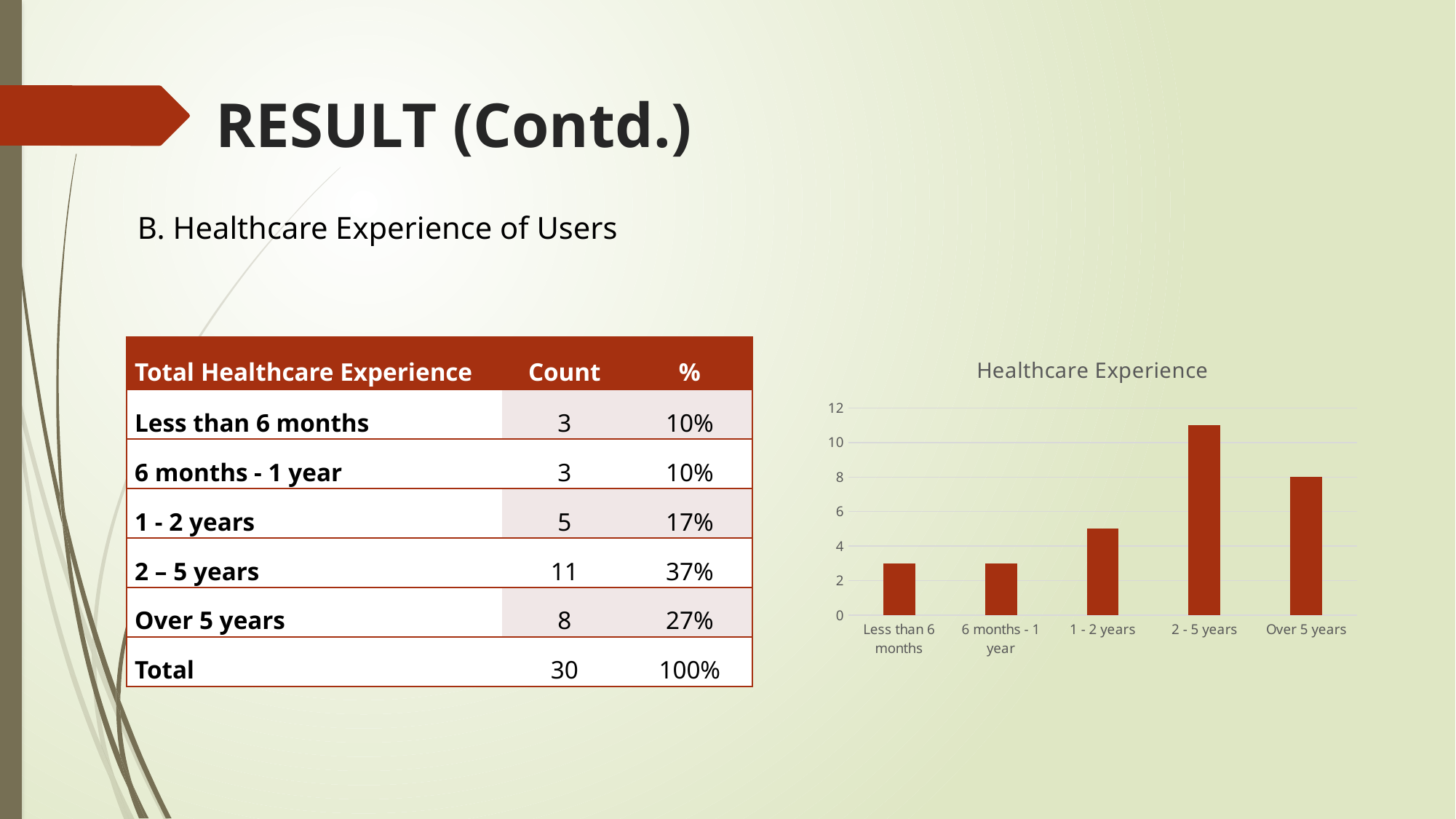
What is the highest value shown on the y axis of the Healthcare Experience chart? 12 Is the value for 2 - 5 years greater or less than 10 in the Healthcare Experience chart? greater Which is larger in the Healthcare Experience chart, 1 - 2 years or Over 5 years? Over 5 years What is the value for Over 5 years in the Healthcare Experience chart? 8 What is the value for 2 - 5 years in the Healthcare Experience chart? 11 What is the value for 1 - 2 years in the Healthcare Experience chart? 5 What type of chart is the Healthcare Experience chart? bar chart Which category has the highest bar in the Healthcare Experience chart? 2 - 5 years What is the title of the chart on the slide? Healthcare Experience How many categories are shown on the x axis of the Healthcare Experience chart? 5 What is the difference between the values for 2 - 5 years and Over 5 years in the Healthcare Experience chart? 3 Is the value for Less than 6 months greater or less than 4 in the Healthcare Experience chart? less